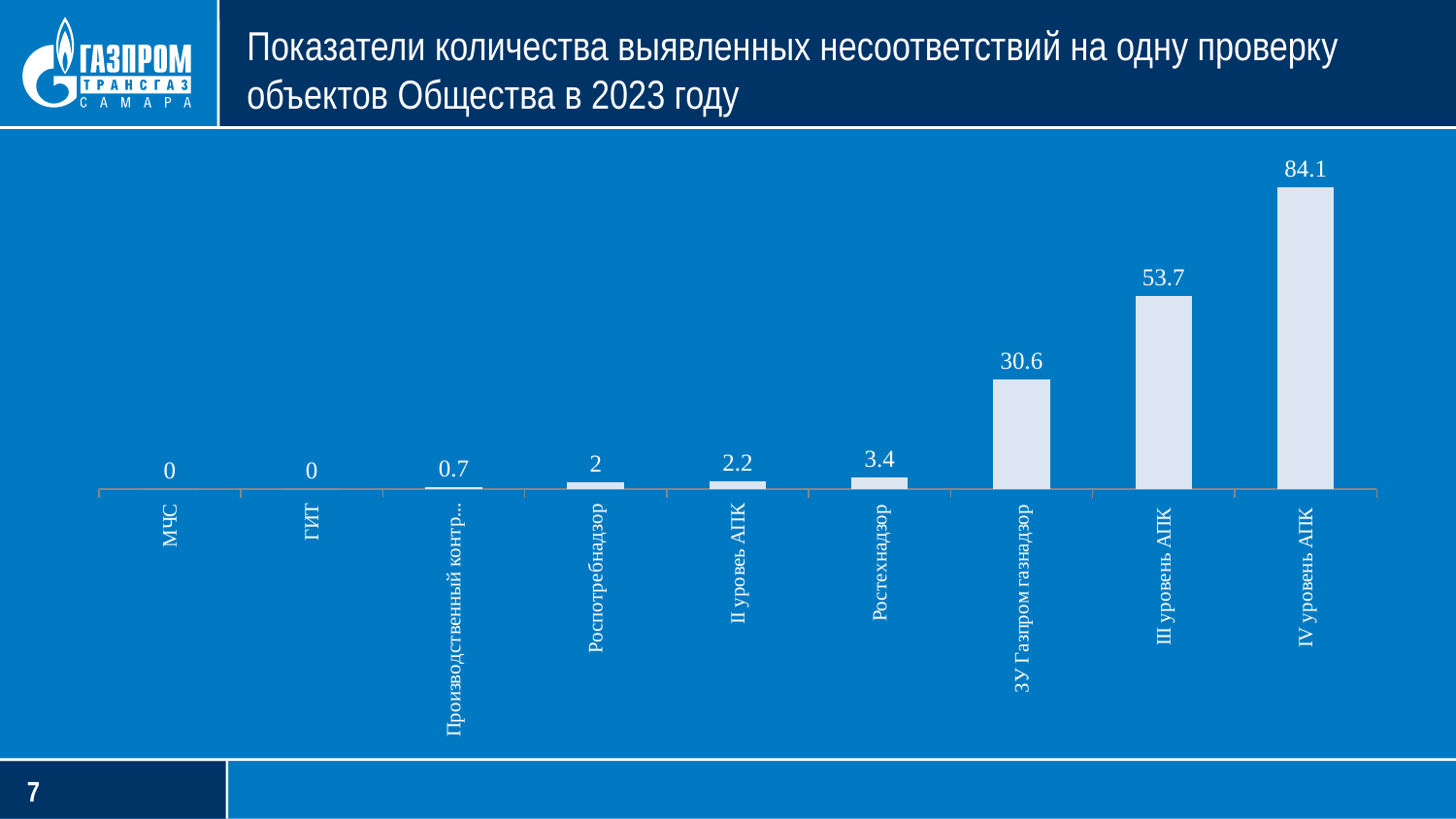
Do the values rise or fall from left to right along the x axis? Rise What kind of chart is shown on the slide? Bar chart What is the value for Ростехнадзор? 3.4 What is the difference between the values for IV уровень АПК and III уровень АПК? 30.4 What is the difference between the values for III уровень АПК and ЗУ Газпром газнадзор? 23.1 What is the value for Роспотребнадзор? 2 What is the value for IV уровень АПК? 84.1 How many categories have a value of 0? 2 How many categories are shown on the chart? 9 Which category has the highest value? IV уровень АПК Which is larger, the value for Ростехнадзор or the value for II уровень АПК? Ростехнадзор What is the value for ЗУ Газпром газнадзор? 30.6